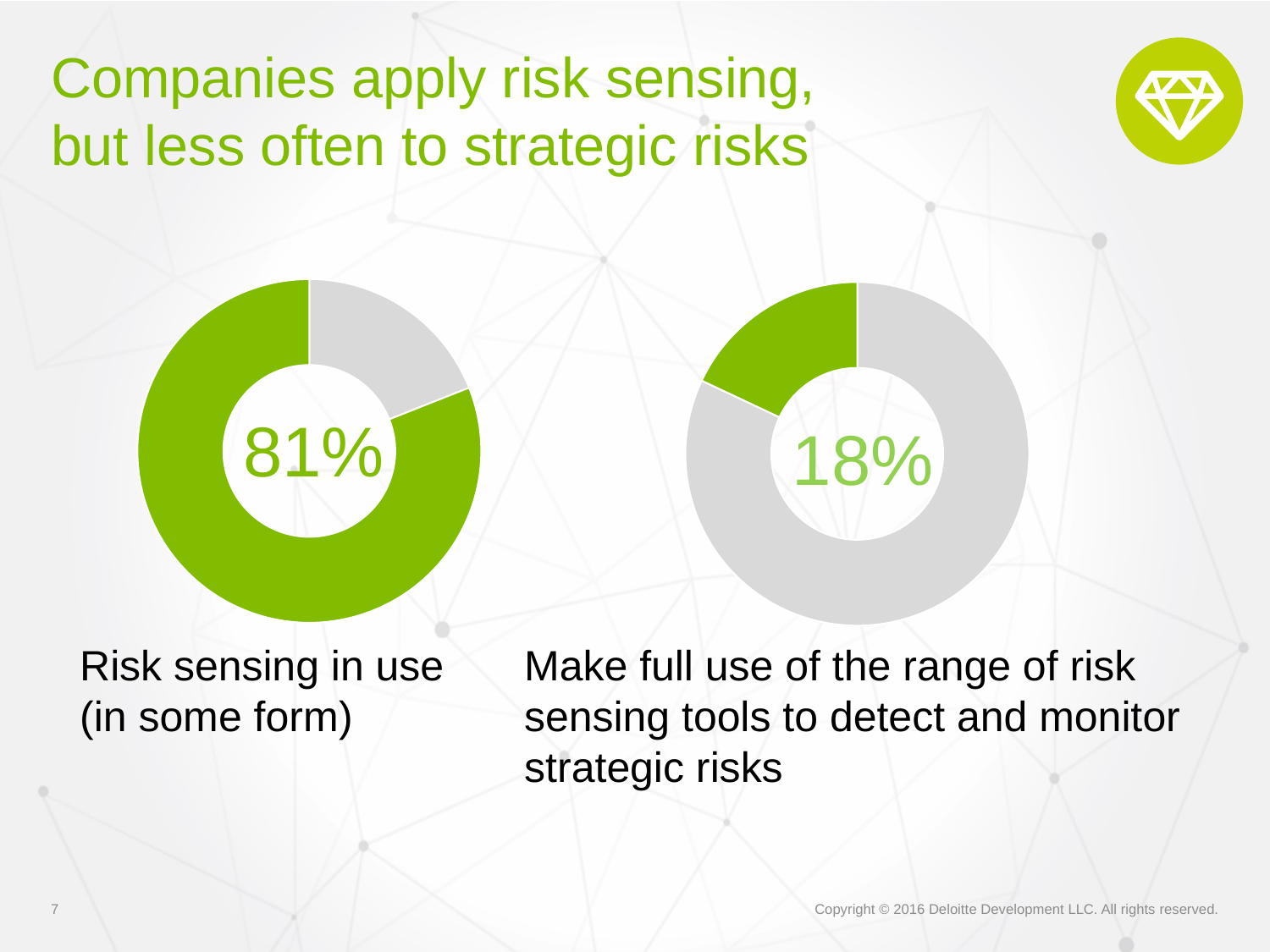
How many donut charts are shown on the slide? 2 On the left donut chart, what share of the ring is filled in green? 81% On the right donut chart, what share of the ring is filled in green? 18% What kind of chart is used on the left of the slide to show the 81% figure? Donut (pie) chart Which is larger: the percentage with risk sensing in use (left chart) or the percentage making full use of risk sensing tools for strategic risks (right chart)? Risk sensing in use (in some form) What is the caption below the left donut chart? Risk sensing in use (in some form) On the right donut chart, what percentage of companies make full use of the range of risk sensing tools to detect and monitor strategic risks? 18% On the left donut chart, what percentage of companies have risk sensing in use (in some form)? 81% What is the difference in percentage points between the left chart's value (81%) and the right chart's value (18%)? 63 percentage points What colour is used for the highlighted (labelled) portion of each donut chart? Green